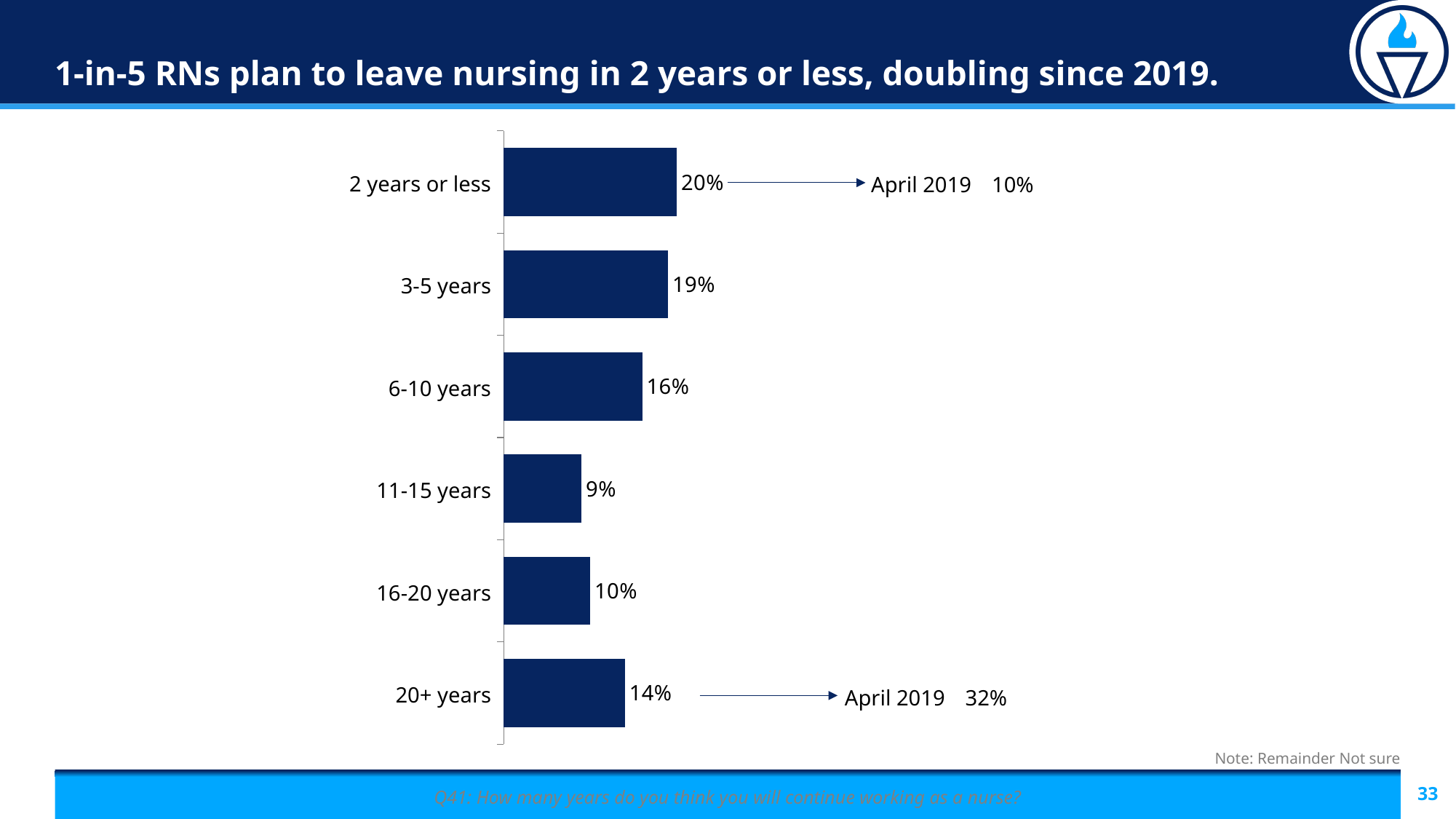
What is the value for the 6-10 years category? 16% What kind of chart is shown on the slide? Bar chart What percentage of RNs plan to continue working as a nurse for 2 years or less? 20% What was the April 2019 value annotated for the 2 years or less category? 10% Which is larger, the value for 6-10 years or the value for 20+ years? 6-10 years How many categories are shown in the chart? 6 Which category has the highest value? 2 years or less What was the April 2019 value annotated for the 20+ years category? 32% What is the difference between the current 2 years or less value and its April 2019 value? 10% What is the difference between the 3-5 years value and the 16-20 years value? 9% Which category has the lowest value? 11-15 years What is the value for the 20+ years category? 14%